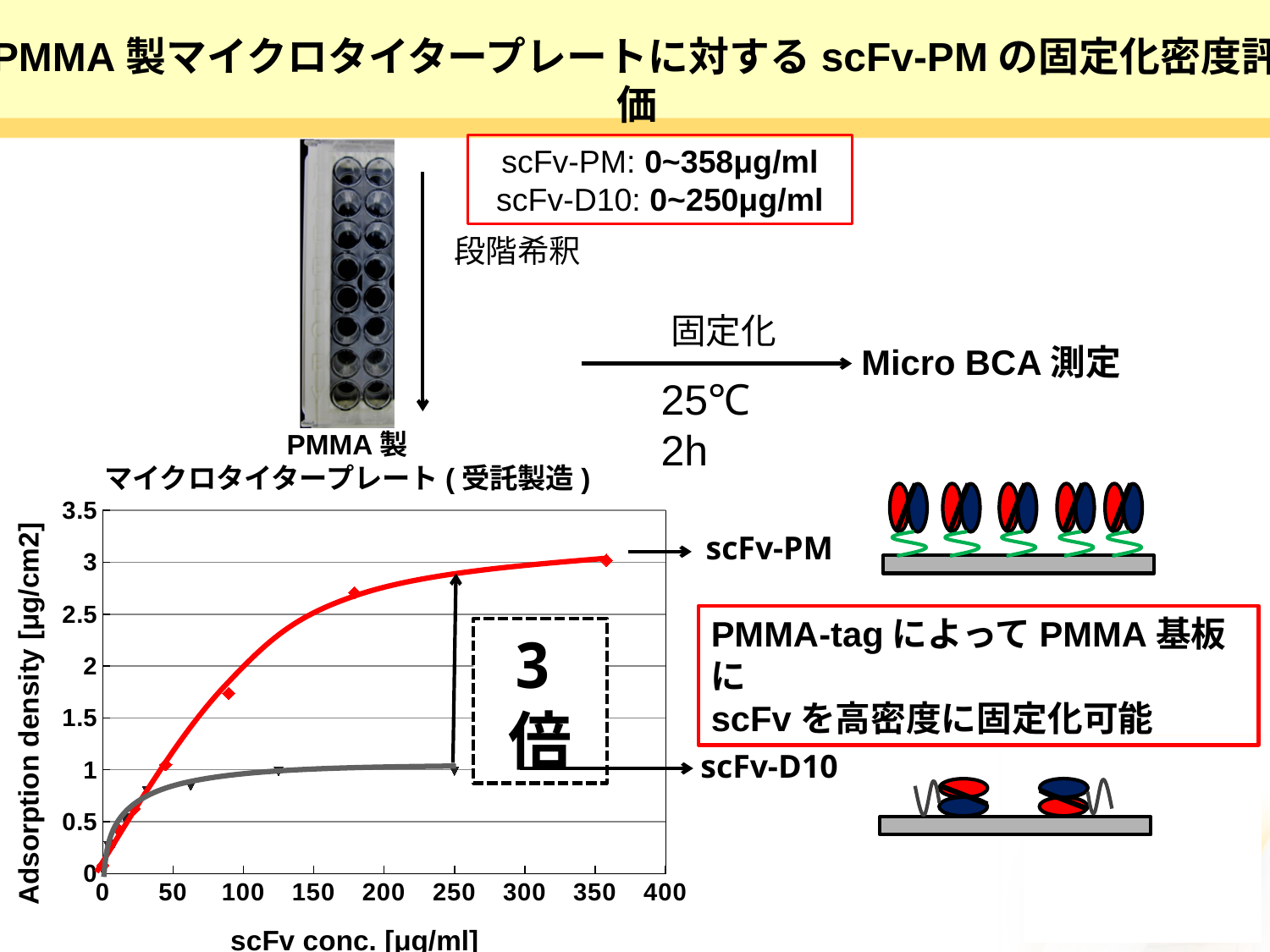
Is the adsorption density of scFv-D10 at 50 μg/ml greater or less than 1.5? less Which series has the higher adsorption density at an scFv concentration of 250 μg/ml, scFv-PM or scFv-D10? scFv-PM Is the adsorption density of scFv-D10 at 250 μg/ml greater or less than 1.5? less What kind of chart is shown on the slide? line chart Is the adsorption density of scFv-PM at 100 μg/ml greater or less than 1.5? greater Does the adsorption density of scFv-PM rise or fall as the scFv concentration increases? rise What is the label of the y axis of the chart? Adsorption density [μg/cm2] What colour is the scFv-PM curve on the chart? red Which series reaches the highest adsorption density on the chart? scFv-PM How many data series are plotted on the chart? 2